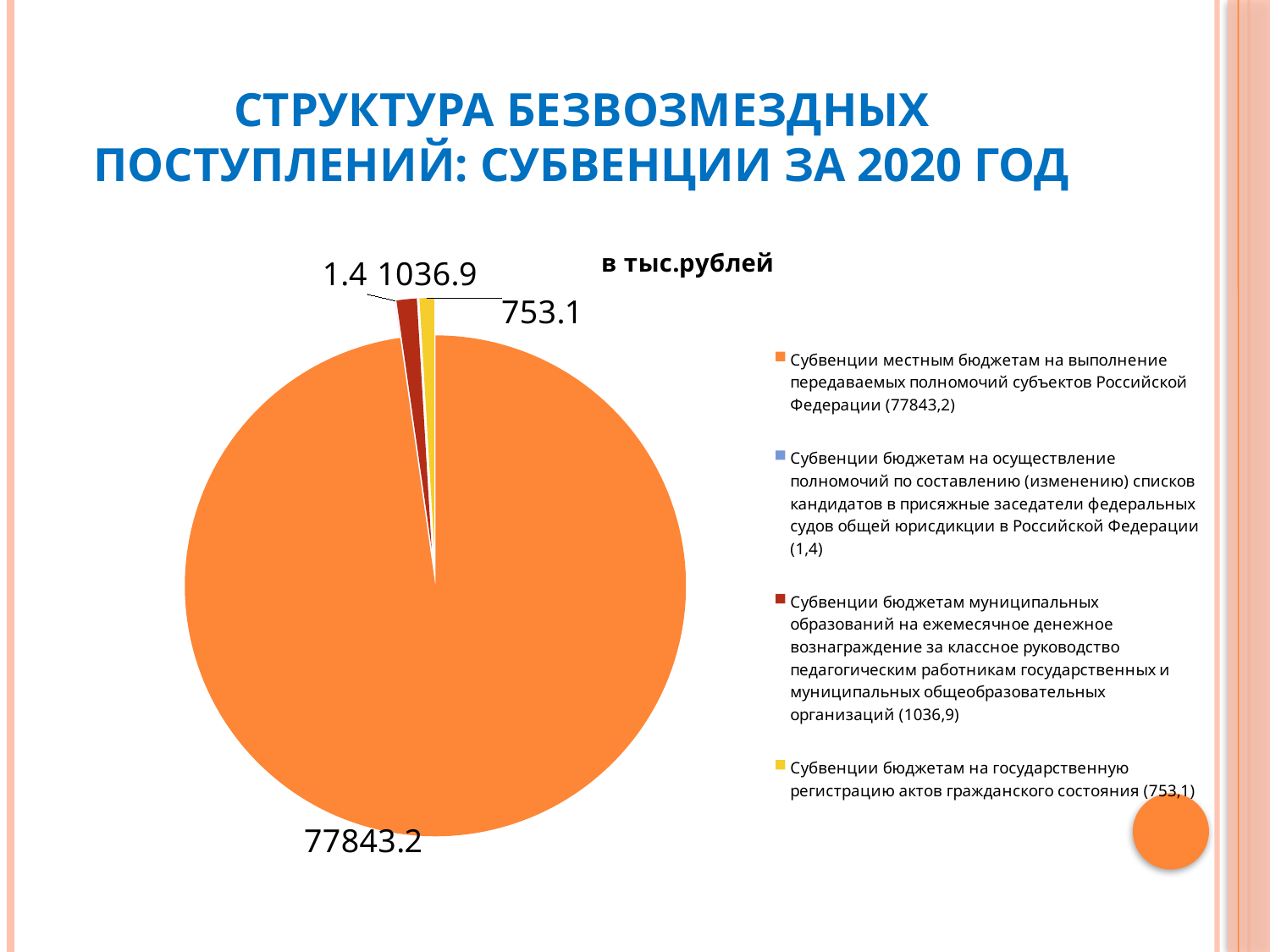
What is the value for subventions for state registration of civil status acts (Субвенции бюджетам на государственную регистрацию актов гражданского состояния)? 753.1 Which legend category has the smallest value in the pie chart? Субвенции бюджетам на осуществление полномочий по составлению (изменению) списков кандидатов в присяжные заседатели федеральных судов общей юрисдикции в Российской Федерации How many slices does the pie chart have? 4 Which legend category has the largest value in the pie chart? Субвенции местным бюджетам на выполнение передаваемых полномочий субъектов Российской Федерации How many entries does the legend list? 4 Which is larger: the slice for class leadership remuneration (1036.9) or the slice for civil status registration (753.1)? Class leadership remuneration (1036.9) What is the total of all four values shown on the pie chart? 79634.6 What is the value for subventions for monthly remuneration for class leadership to teachers (Субвенции бюджетам муниципальных образований на ежемесячное денежное вознаграждение за классное руководство)? 1036.9 What is the difference between the values 1036.9 and 753.1 shown on the pie chart? 283.8 What kind of chart is shown on the slide? Pie chart In what units are the values on the chart expressed, according to the label above the pie? в тыс.рублей What is the value of the largest slice of the pie chart? 77843.2